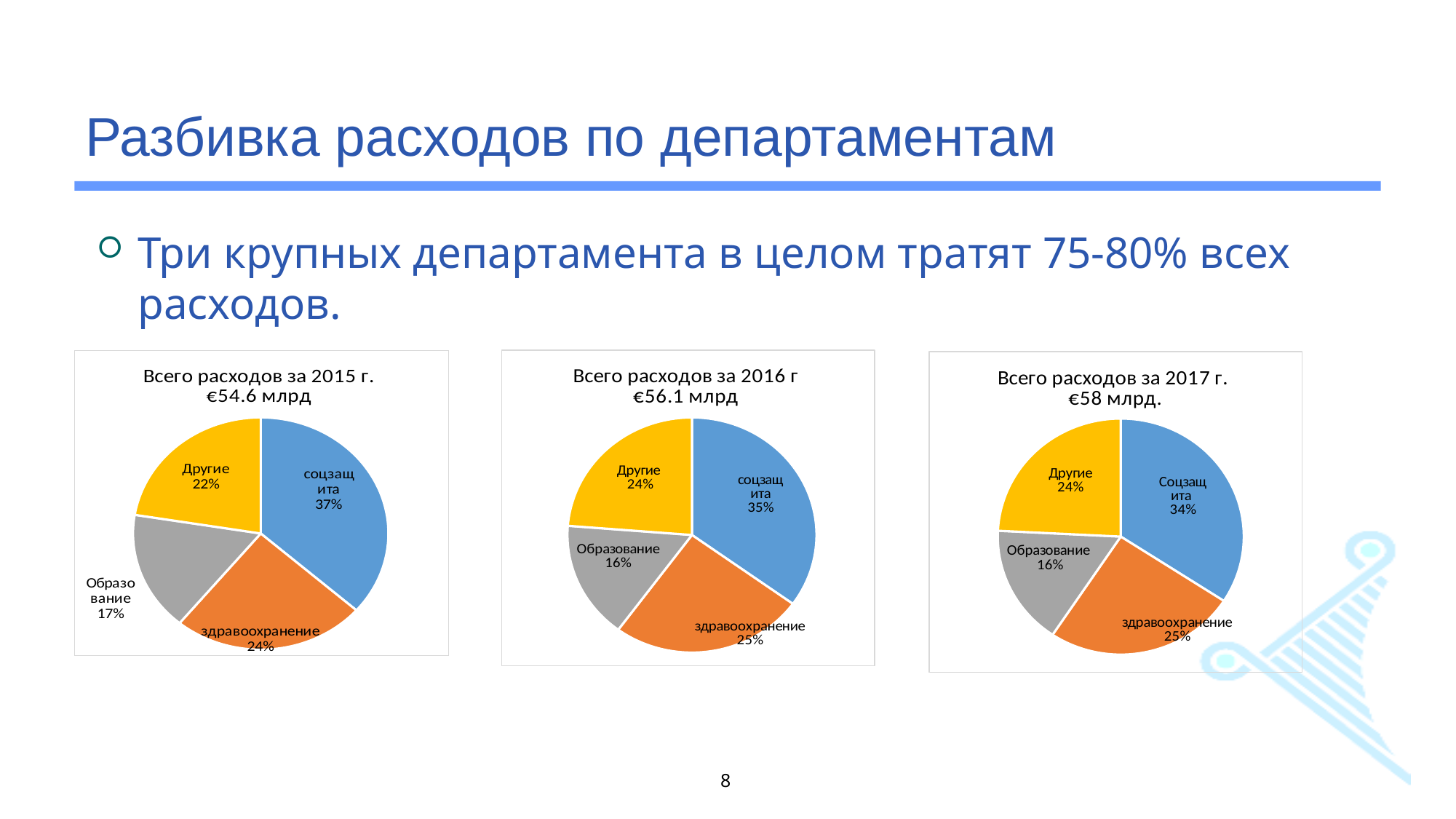
How many pie charts are shown on the slide? 3 In the chart titled "Всего расходов за 2015 г. €54.6 млрд", what share does соцзащита have? 37% In the chart titled "Всего расходов за 2015 г. €54.6 млрд", which category has the largest slice? соцзащита How many slices does the chart titled "Всего расходов за 2016 г €56.1 млрд" have? 4 What type of chart is the chart titled "Всего расходов за 2017 г. €58 млрд."? pie chart In the chart titled "Всего расходов за 2015 г. €54.6 млрд", what is the combined share of соцзащита, здравоохранение and Образование? 78% In the chart titled "Всего расходов за 2017 г. €58 млрд.", what share does Образование have? 16% In the chart titled "Всего расходов за 2016 г €56.1 млрд", which category has the smallest slice? Образование In the chart titled "Всего расходов за 2016 г €56.1 млрд", what share does здравоохранение have? 25% In the chart titled "Всего расходов за 2017 г. €58 млрд.", what is the difference in percentage points between Соцзащита and здравоохранение? 9 In the chart titled "Всего расходов за 2015 г. €54.6 млрд", which is larger: Другие or Образование? Другие In the chart titled "Всего расходов за 2016 г €56.1 млрд", what colour is the Другие slice? yellow